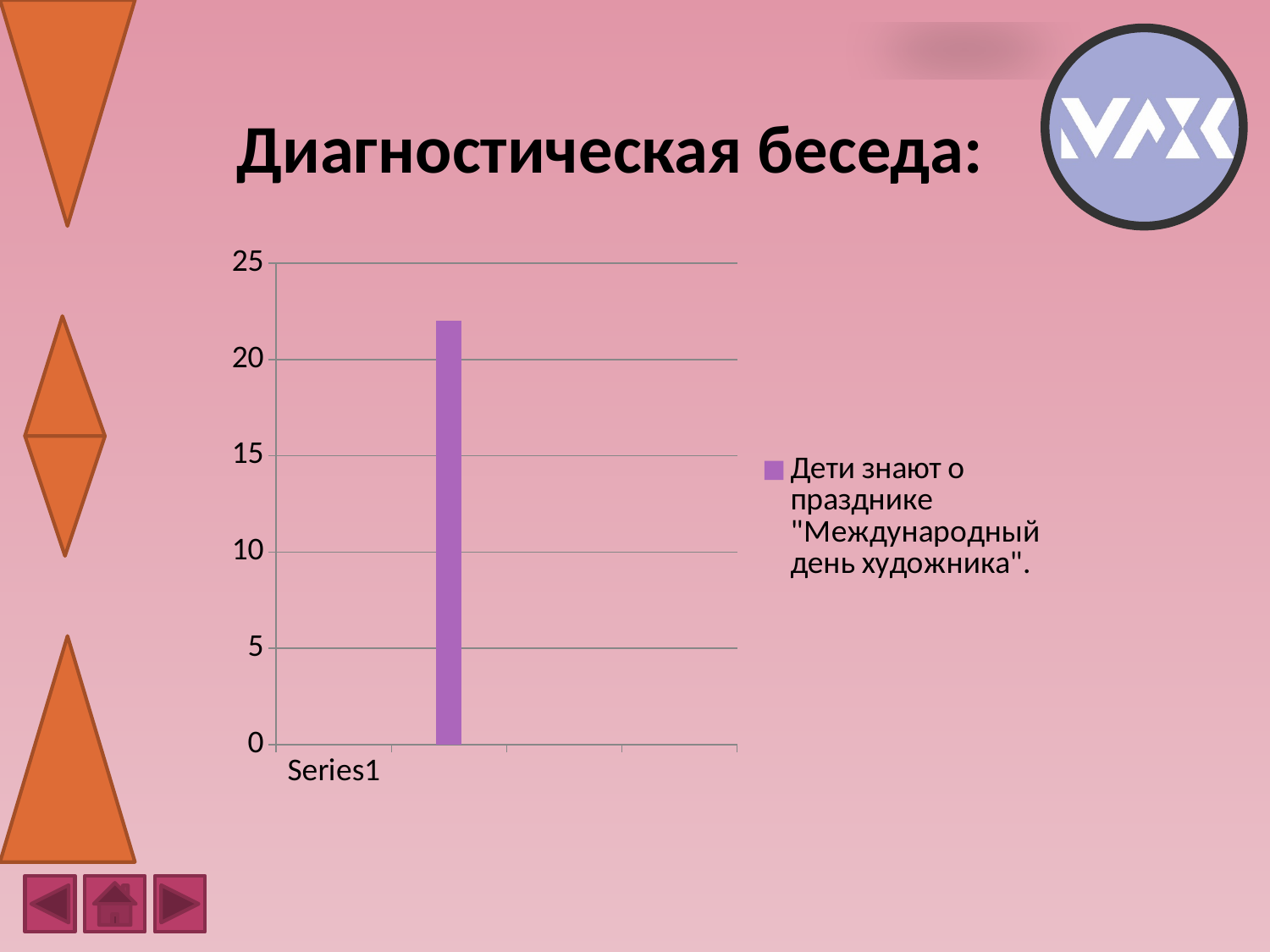
How many bars are plotted in the chart? 1 What is the label shown under the x axis of the chart? Series1 What is the legend entry of the chart? Дети знают о празднике "Международный день художника". Is the value of the bar for Series1 greater or less than 15? greater How many series does the legend list? 1 Is the value of the bar for Series1 greater or less than 20? greater Is the value of the bar for Series1 greater or less than 25? less What kind of chart is shown on the slide? bar chart What is the highest value shown on the vertical axis of the chart? 25